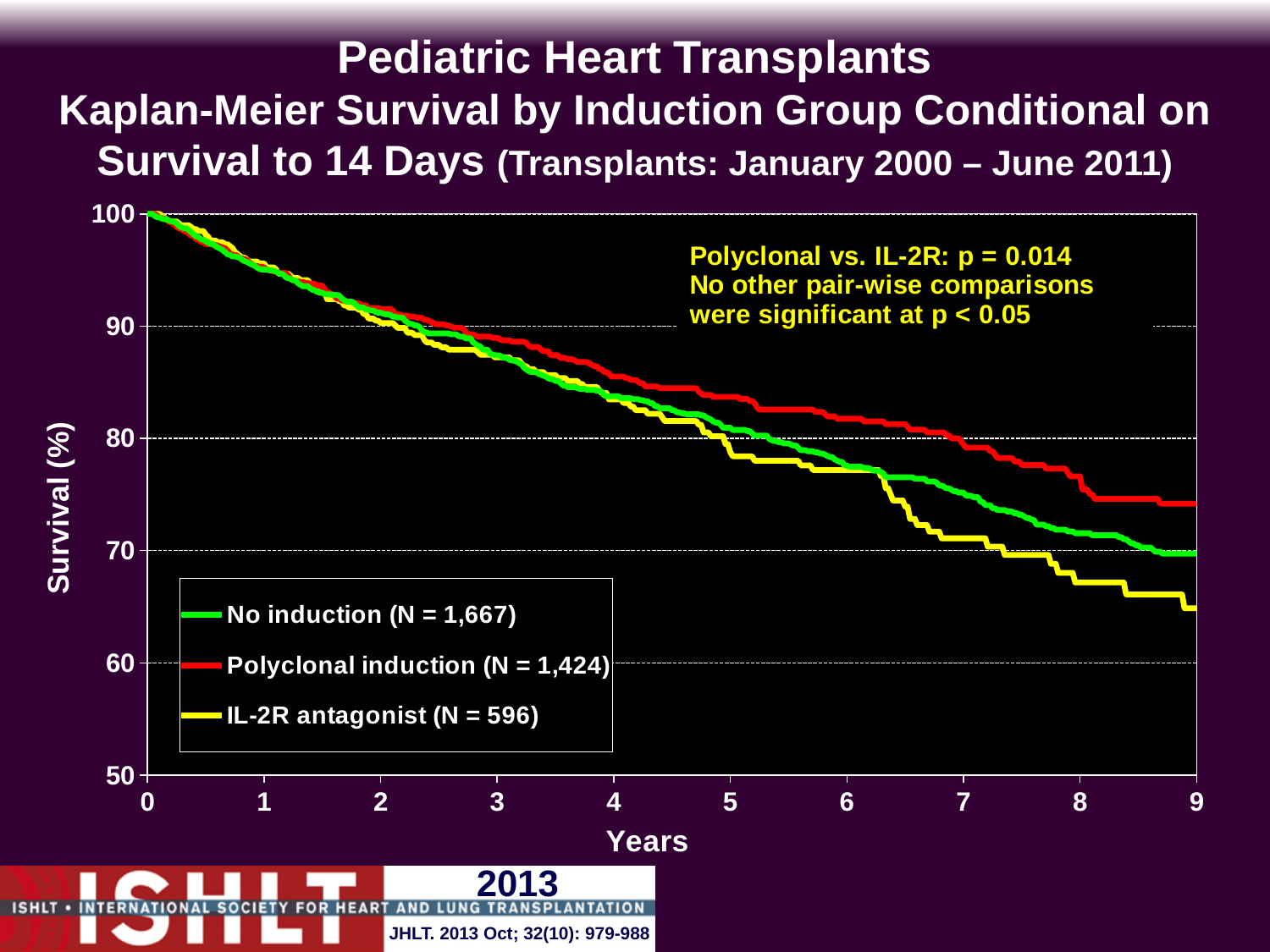
Which induction group has the highest survival at 9 years? Polyclonal induction At 6 years, which group has higher survival: Polyclonal induction or IL-2R antagonist? Polyclonal induction Which induction group has the lowest survival at 9 years? IL-2R antagonist Do the survival curves rise or fall as years increase? fall What is the N for the IL-2R antagonist group shown in the legend? 596 Is the survival for the IL-2R antagonist group at 9 years greater or less than 70? less How many series does the legend list? 3 What kind of chart is shown on the slide? Line chart (Kaplan-Meier survival curve) Is the survival for the Polyclonal induction group at 9 years greater or less than 70? greater What is the N for the No induction group shown in the legend? 1,667 What is the N for the Polyclonal induction group shown in the legend? 1,424